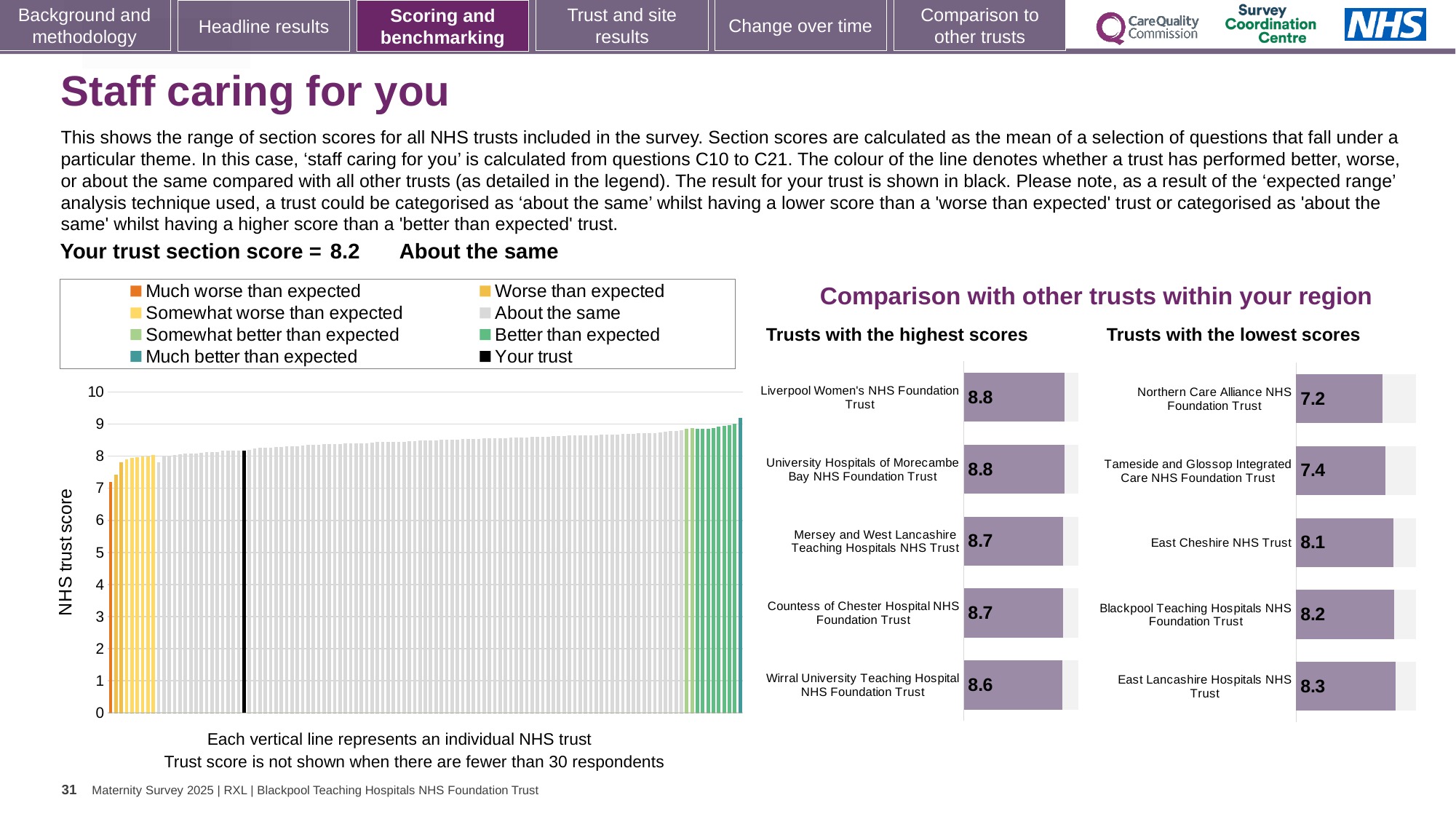
In the 'Trusts with the lowest scores' chart, what is the score for Northern Care Alliance NHS Foundation Trust? 7.2 What kind of chart is the NHS trust score chart on the left of the slide? Bar chart In the 'Trusts with the lowest scores' chart, which trust has the highest score? East Lancashire Hospitals NHS Trust In the NHS trust score chart on the left, do the values rise or fall from left to right? Rise In the 'Trusts with the highest scores' chart, what is the difference between the scores of Liverpool Women's NHS Foundation Trust and Wirral University Teaching Hospital NHS Foundation Trust? 0.2 In the 'Trusts with the highest scores' chart, what is the score for Wirral University Teaching Hospital NHS Foundation Trust? 8.6 In the 'Trusts with the lowest scores' chart, which trust has the lowest score? Northern Care Alliance NHS Foundation Trust How many trusts are shown in the 'Trusts with the highest scores' chart? 5 How many entries does the legend of the NHS trust score chart on the left list? 8 What is the title above the two charts on the right-hand side of the slide? Comparison with other trusts within your region In the NHS trust score chart on the left, is the value of the leftmost (orange) bar greater or less than 8? less In the 'Trusts with the lowest scores' chart, which has the larger score: East Cheshire NHS Trust or Blackpool Teaching Hospitals NHS Foundation Trust? Blackpool Teaching Hospitals NHS Foundation Trust